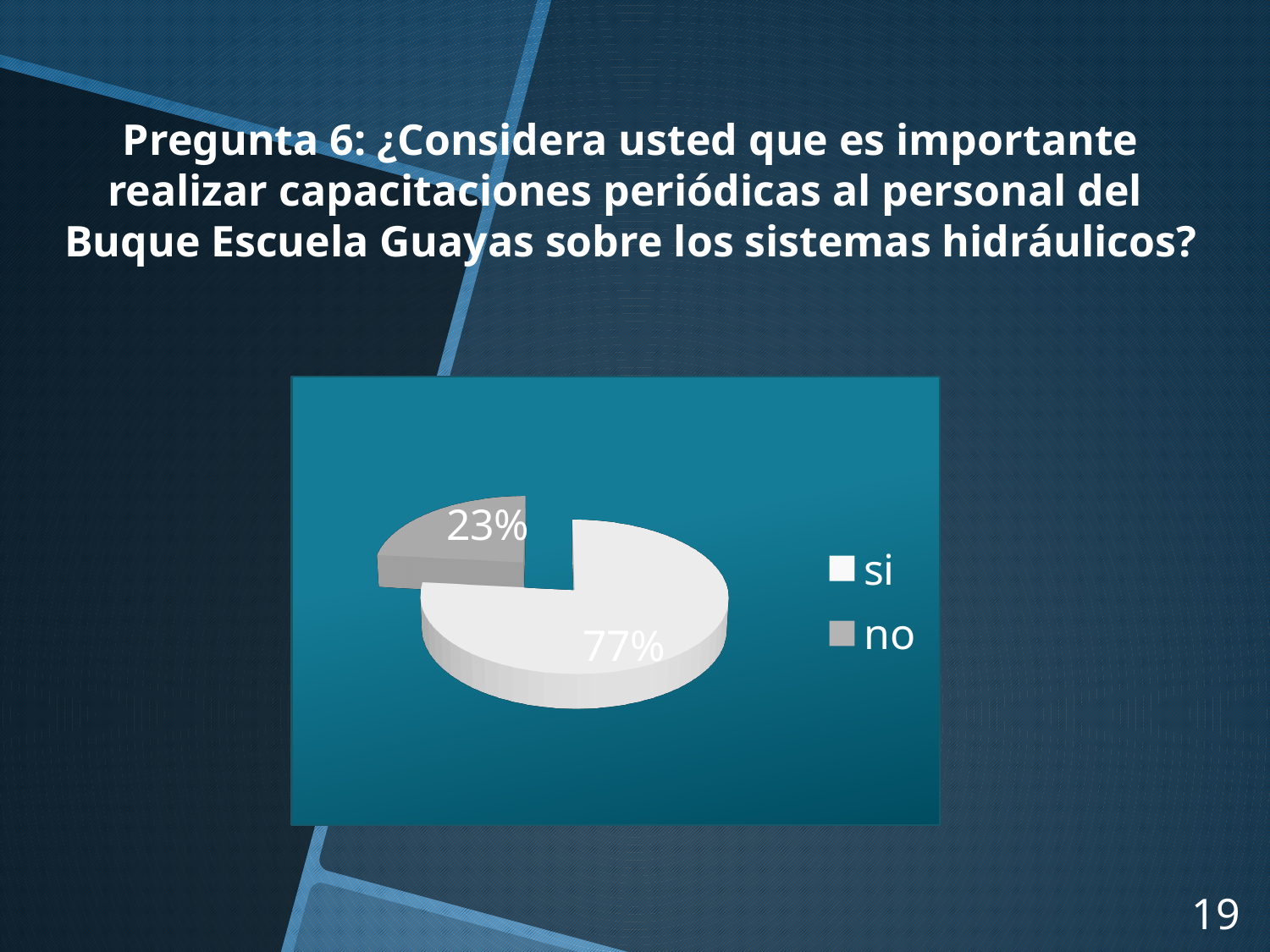
What colour is the "si" slice in the pie chart? white Which response has the smallest share of the pie? no What kind of chart is shown on the slide? pie chart Which slice is larger, "si" or "no"? si What share of the pie does the "no" slice represent? 23% What is the difference in percentage points between the "si" and "no" slices? 54 How many categories does the pie chart show? 2 What percentage of respondents answered "si"? 77% What are the two entries listed in the chart legend? si, no Which response has the largest share of the pie? si What percentage of respondents answered "no"? 23%